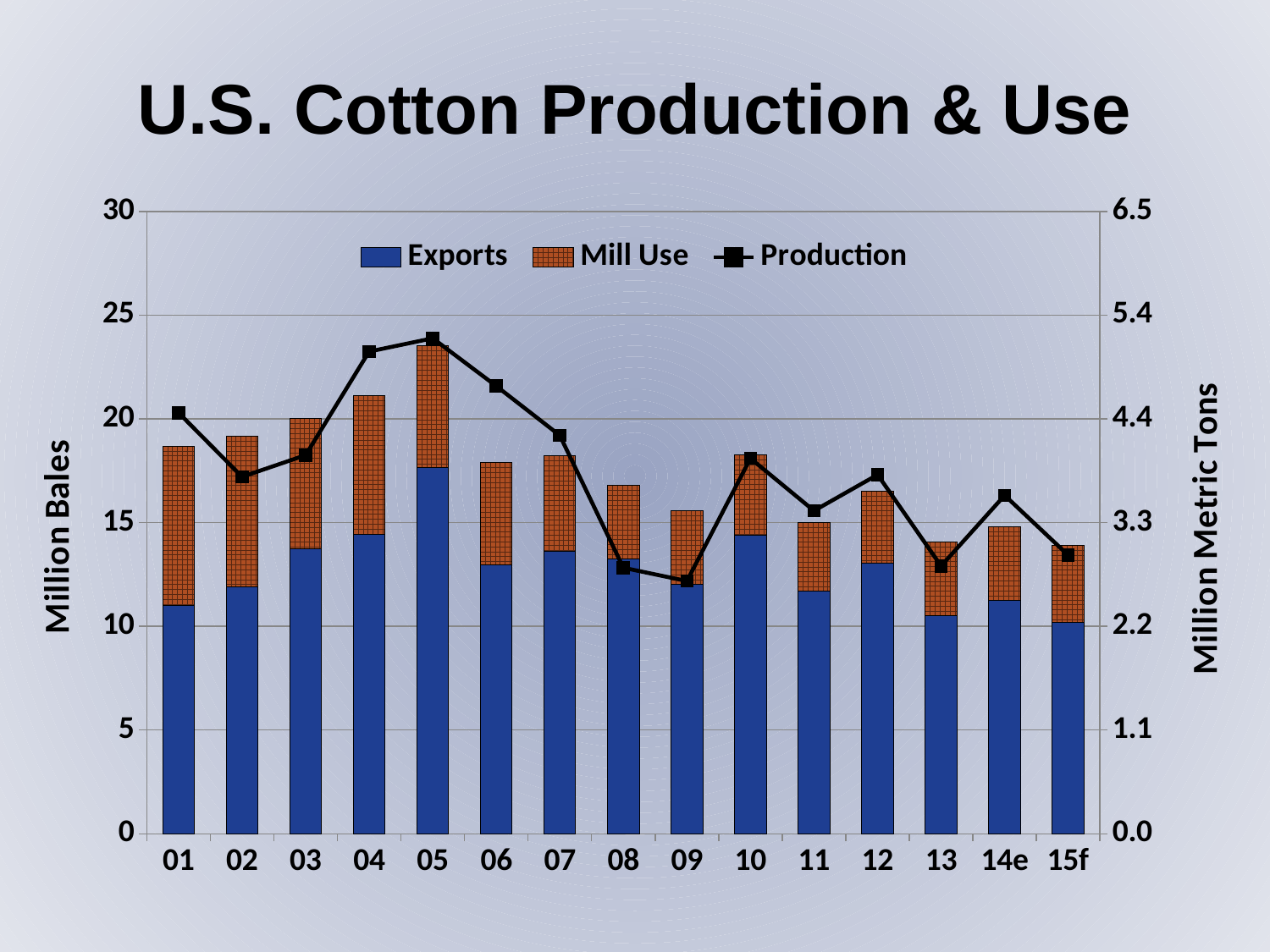
In which year does the Production line reach its lowest point? 09 Is the Exports value for 15f greater or less than 15 million bales? less What is the label of the right-hand vertical axis? Million Metric Tons Is the Exports value for 05 greater or less than 15 million bales? greater In which year is the Exports bar the highest? 05 What kind of chart is shown on the slide? bar and line chart Is the Production value for 08 greater or less than 3.3 million metric tons? less How many years are shown along the x axis? 15 Which year has the larger Exports value, 01 or 05? 05 In which year does the Production line reach its highest point? 05 How many series does the legend list? 3 Does the Production line rise or fall from 05 to 09? fall